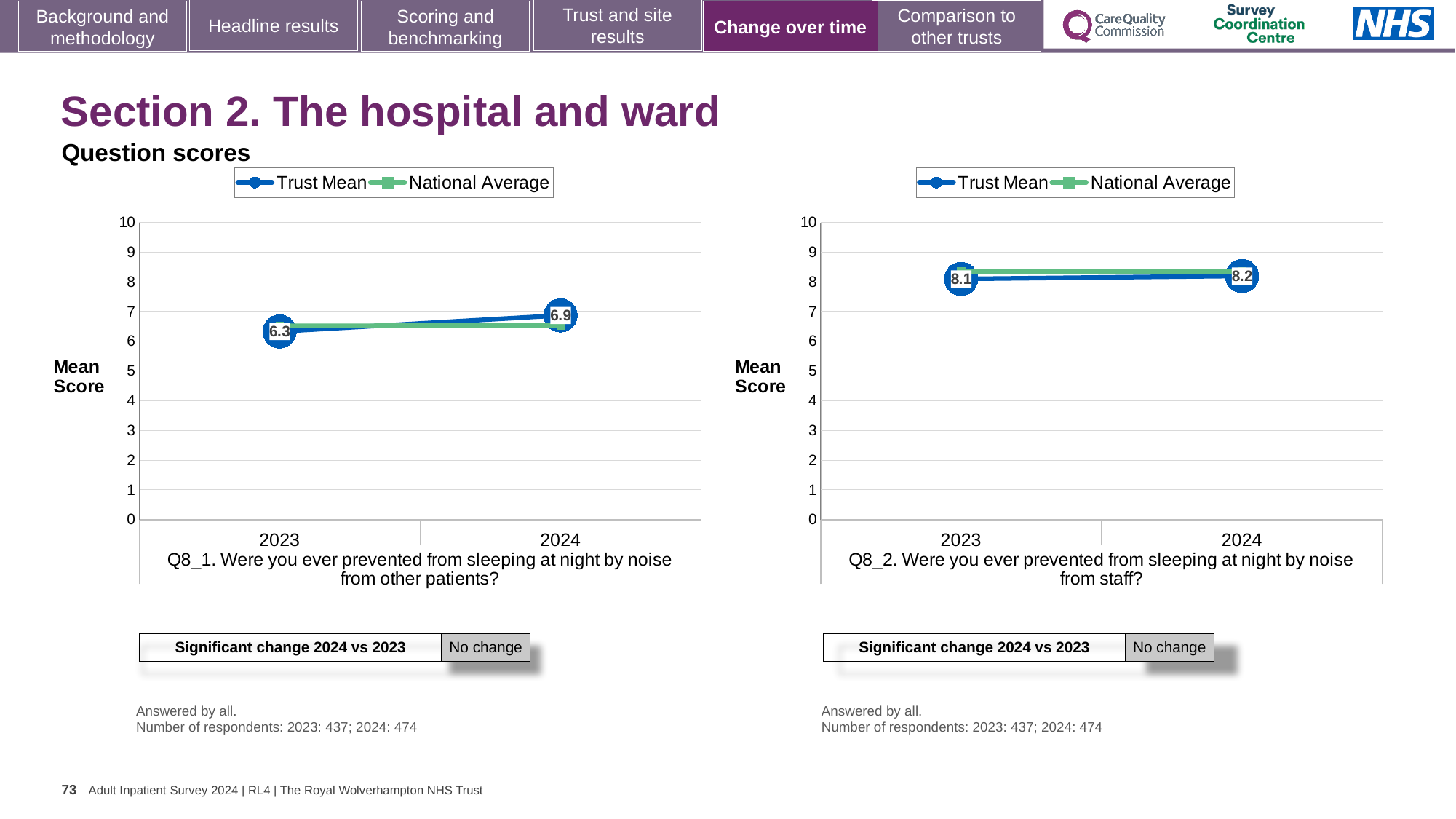
In the left chart (Q8_1), what is the Trust Mean score for 2023? 6.3 In the left chart (Q8_1), for 2024, which is larger: the Trust Mean or the National Average? Trust Mean In the left chart (Q8_1), is the National Average value for 2024 greater or less than 7? less What kind of chart is the left chart (Q8_1)? line chart How many years are plotted on the x axis of the left chart (Q8_1)? 2 In the right chart (Q8_2), what is the Trust Mean score for 2023? 8.1 In the left chart (Q8_1), by how much did the Trust Mean change from 2023 to 2024? 0.6 In the right chart (Q8_2), what is the Trust Mean score for 2024? 8.2 In the left chart (Q8_1), does the Trust Mean rise or fall from 2023 to 2024? rise How many series does the legend of the right chart (Q8_2) list? 2 In the left chart (Q8_1), what is the Trust Mean score for 2024? 6.9 In the right chart (Q8_2), which year has the higher Trust Mean score? 2024